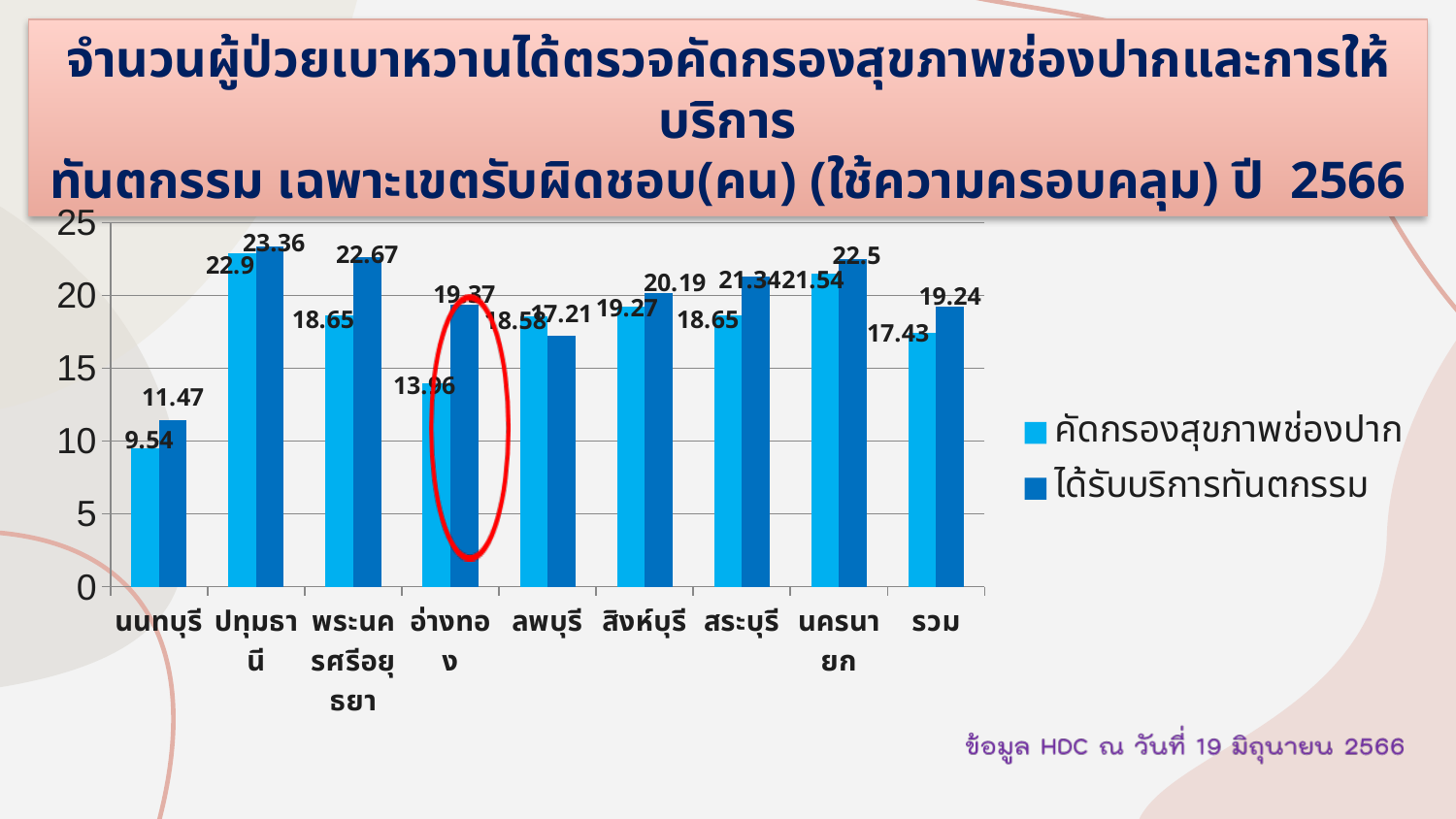
Which province has the highest value for คัดกรองสุขภาพช่องปาก? ปทุมธานี What is the value of ได้รับบริการทันตกรรม for อ่างทอง? 19.37 Which province has the lowest value for ได้รับบริการทันตกรรม? นนทบุรี What is the difference between ได้รับบริการทันตกรรม and คัดกรองสุขภาพช่องปาก for อ่างทอง? 5.41 How many categories are shown on the x axis? 9 How many series does the legend list? 2 What is the value of คัดกรองสุขภาพช่องปาก for นนทบุรี? 9.54 What kind of chart is shown on the slide? bar chart What is the value of ได้รับบริการทันตกรรม for รวม? 19.24 Which category is circled in red on the chart? อ่างทอง For ลพบุรี, which is larger: คัดกรองสุขภาพช่องปาก or ได้รับบริการทันตกรรม? คัดกรองสุขภาพช่องปาก Is the value of คัดกรองสุขภาพช่องปาก for นนทบุรี greater or less than 10? less